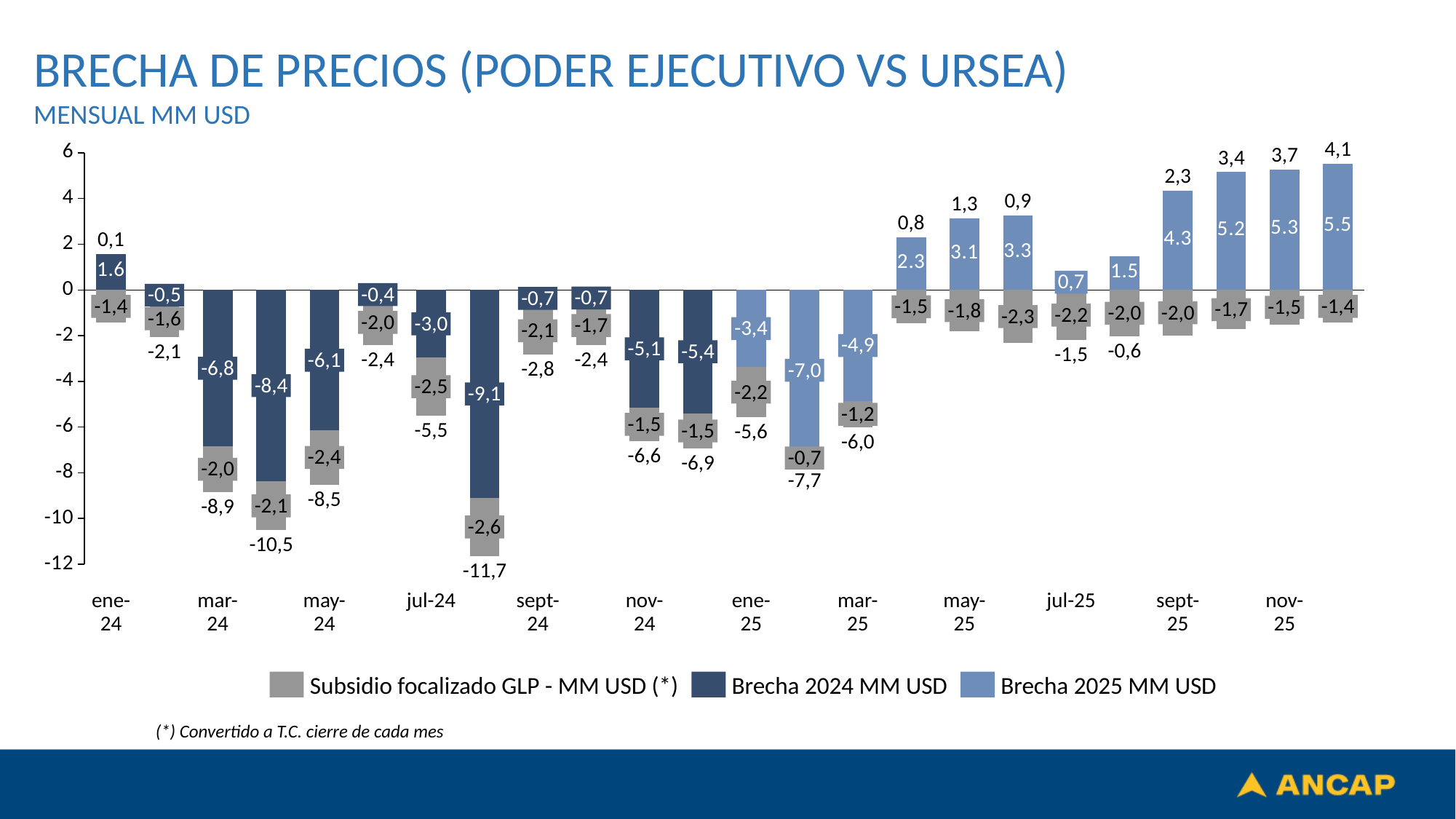
Is the total value for mar-25 greater or less than -4? less Which month has the highest Brecha 2024 MM USD value? ene-24 What is the difference between the total for mar-24 (-8,9) and the total for may-24 (-8,5)? 0,4 What is the Brecha 2024 MM USD value for ene-24? 1.6 What is the total value shown above the bar for nov-25? 3,7 What is the total value shown for mar-24? -8,9 What kind of chart is shown on the slide? bar chart Do the total values rise or fall from sept-25 to nov-25? rise What is the Subsidio focalizado GLP value for jul-24? -2,5 Which is larger, the Brecha 2025 value for sept-25 or for may-25? sept-25 What is the Brecha 2025 MM USD value for sept-25? 4.3 How many series does the legend list? 3